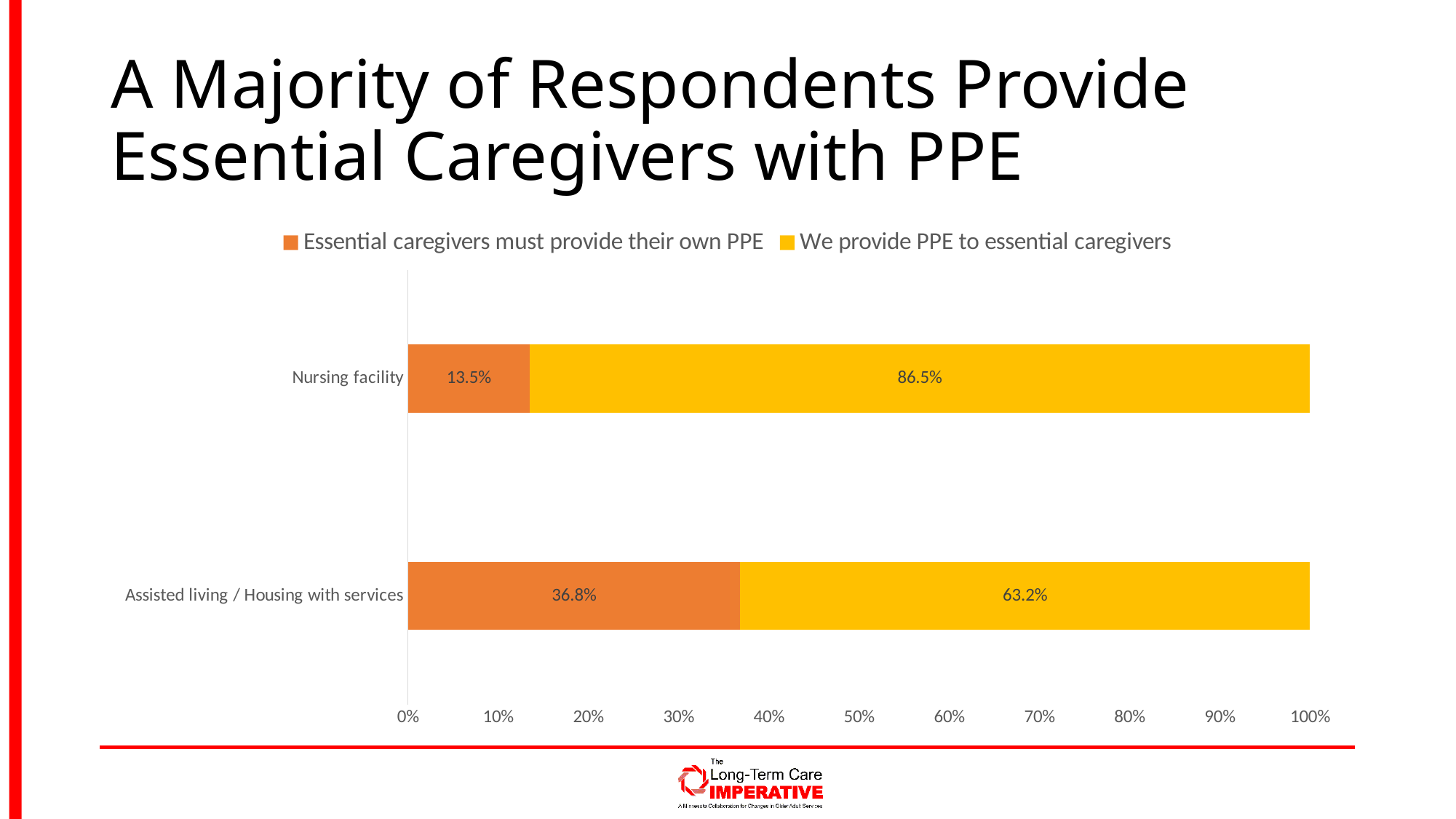
What percentage of Assisted living / Housing with services respondents provide PPE to essential caregivers? 63.2% What percentage of Nursing facility respondents say essential caregivers must provide their own PPE? 13.5% What percentage of Assisted living / Housing with services respondents say essential caregivers must provide their own PPE? 36.8% Which category has the lower share of respondents saying essential caregivers must provide their own PPE? Nursing facility What is the difference in percentage points between the 'We provide PPE to essential caregivers' values for Nursing facility and Assisted living / Housing with services? 23.3 percentage points What colour represents the 'We provide PPE to essential caregivers' series? Yellow Is the 'Essential caregivers must provide their own PPE' value larger for Nursing facility or for Assisted living / Housing with services? Assisted living / Housing with services What percentage of Nursing facility respondents provide PPE to essential caregivers? 86.5% What kind of chart is shown on the slide? Stacked bar chart Which category has the higher share of respondents who provide PPE to essential caregivers? Nursing facility How many categories are shown on the chart? 2 How many series does the legend list? 2